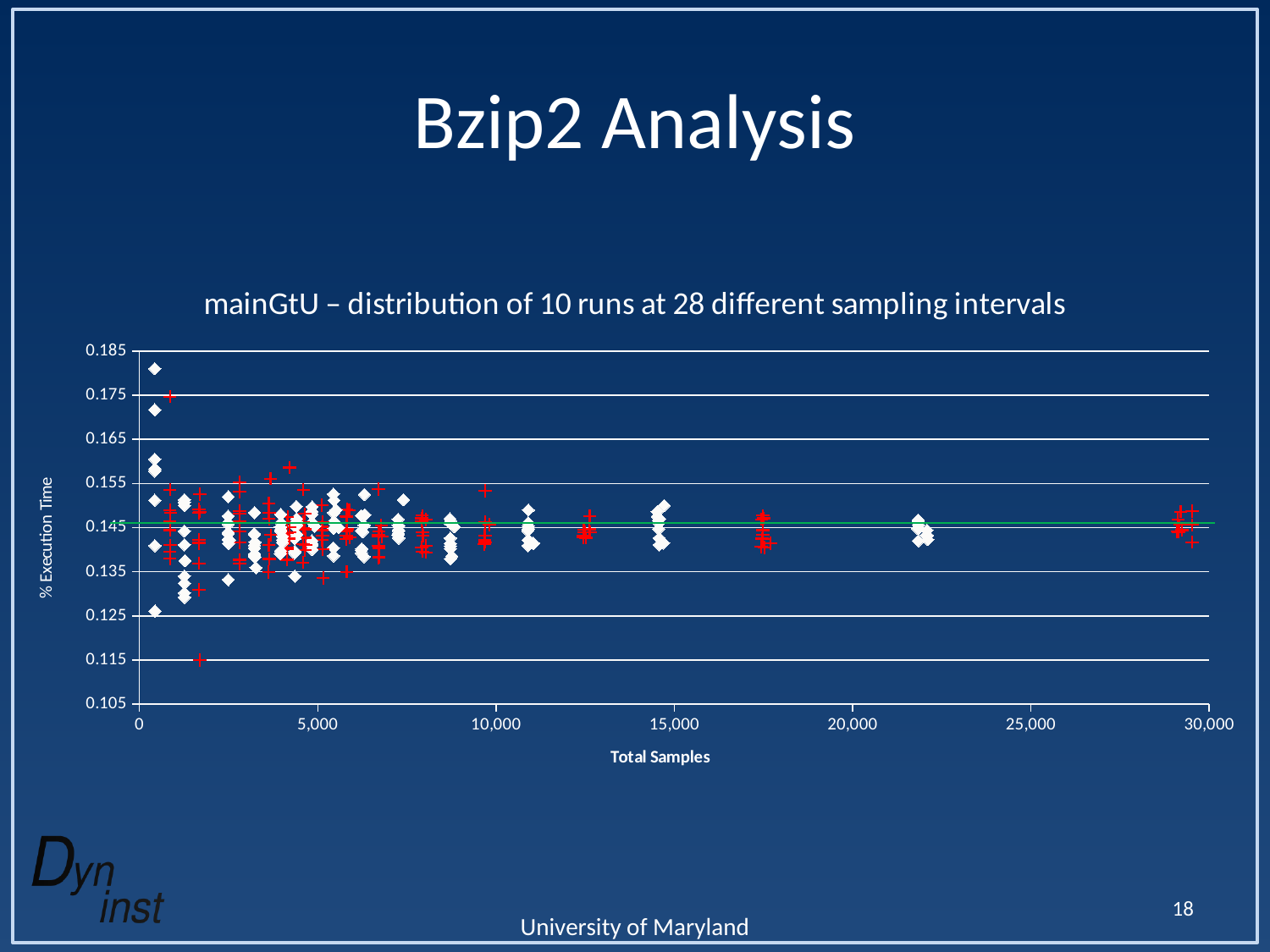
What kind of chart is shown on the slide? scatter chart What is the title of the chart? mainGtU – distribution of 10 runs at 28 different sampling intervals Is the highest point plotted near 22,000 total samples greater or less than 0.155 % execution time? less Are the points plotted near 30,000 total samples greater or less than 0.125 % execution time? greater What is the label of the x axis of the chart? Total Samples Is the green horizontal line on the chart greater or less than 0.135 % execution time? greater Does the vertical spread of the plotted points narrow or widen as total samples increase along the x axis? narrows